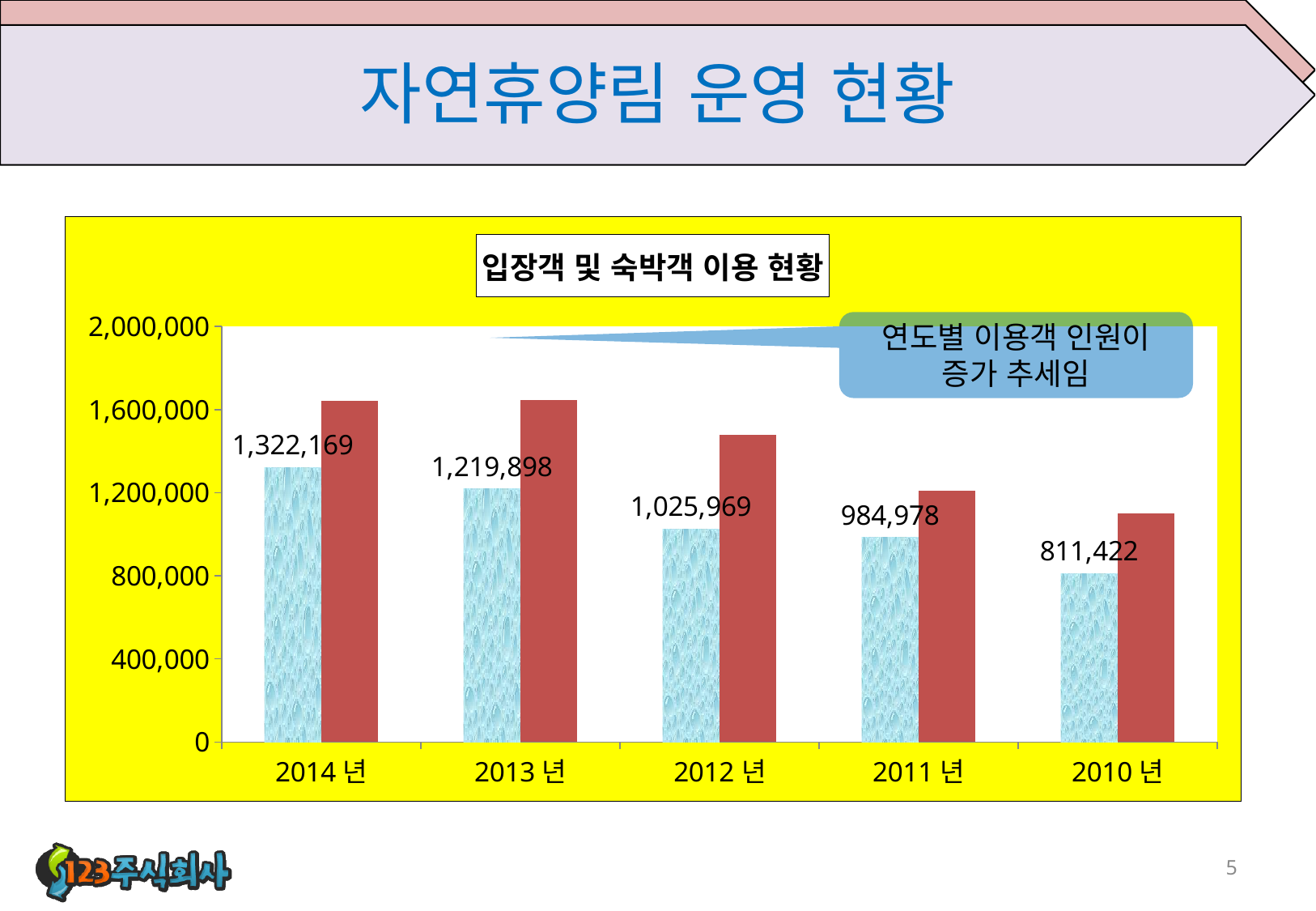
Which year has the lowest value among the light blue bars? 2010 년 What is the value of the light blue bar for 2010 년? 811,422 What is the value of the light blue bar for 2014 년? 1,322,169 Which is larger, the light blue bar value for 2011 년 or for 2010 년? 2011 년 Which year has the highest value among the light blue bars? 2014 년 What is the value of the light blue bar for 2012 년? 1,025,969 Is the value of the red bar for 2014 년 greater or less than 1,600,000? greater What is the difference between the light blue bar values for 2014 년 and 2013 년? 102,271 How many years are shown on the x axis? 5 Is the value of the red bar for 2010 년 greater or less than 1,200,000? less What kind of chart is shown on the slide? bar chart What is the title of the chart? 입장객 및 숙박객 이용 현황